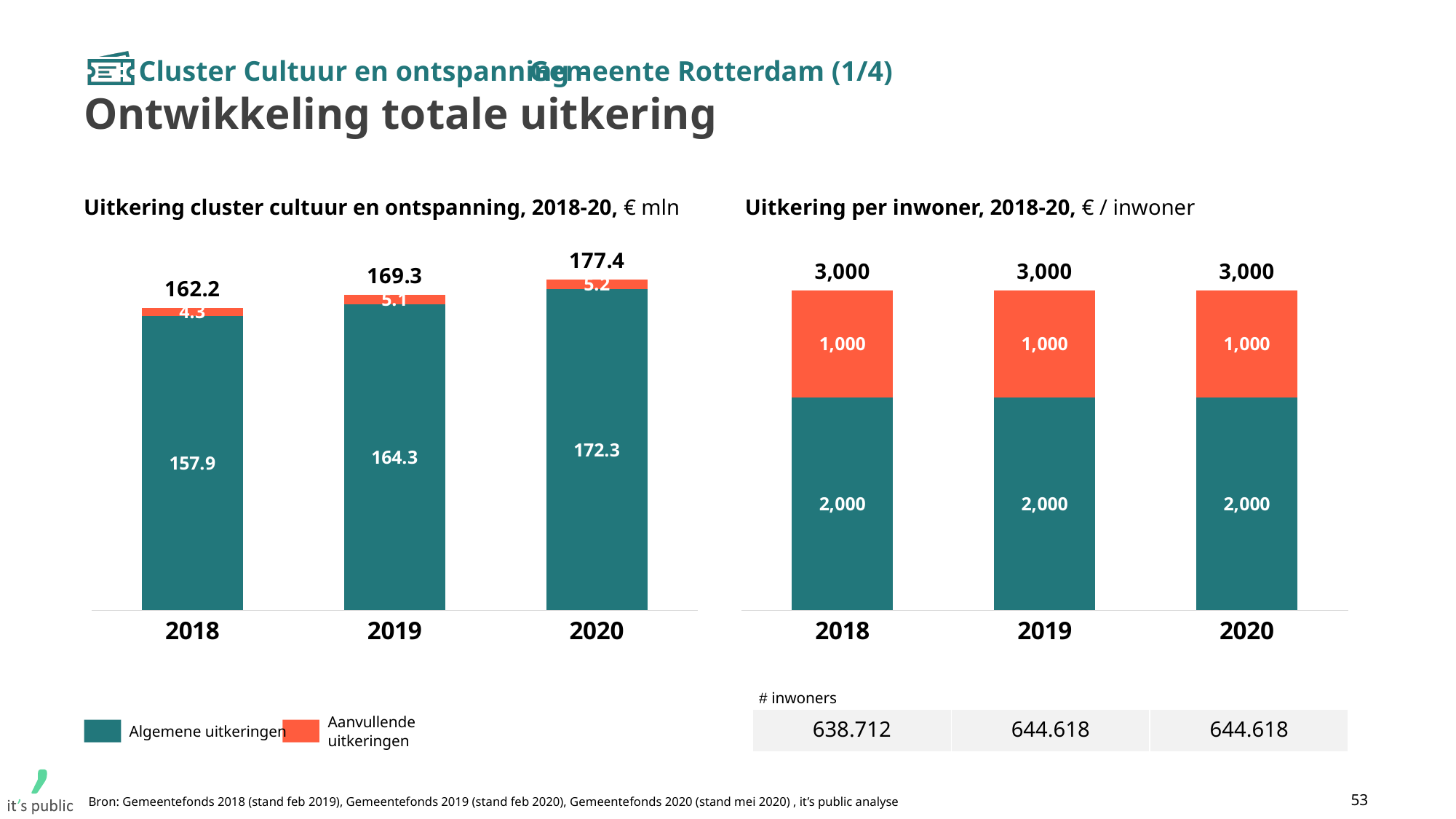
In the left chart (Uitkering cluster cultuur en ontspanning), what is the value of Algemene uitkeringen for 2020? 172.3 In the left chart (Uitkering cluster cultuur en ontspanning), what is the value of Aanvullende uitkeringen for 2018? 4.3 How many series does the legend list for the left chart? 2 In the left chart (Uitkering cluster cultuur en ontspanning), which year has the highest total uitkering? 2020 What kind of chart is the left chart (Uitkering cluster cultuur en ontspanning)? Stacked bar chart In the left chart (Uitkering cluster cultuur en ontspanning), what is the difference between the Algemene uitkeringen values for 2020 and 2018? 14.4 In the right chart (Uitkering per inwoner), what is the value of the orange (Aanvullende uitkeringen) segment for 2019? 1,000 In the left chart (Uitkering cluster cultuur en ontspanning), do the total values rise or fall from 2018 to 2020? rise In the right chart (Uitkering per inwoner), what is the total of the stacked bar for 2020? 3,000 In the left chart (Uitkering cluster cultuur en ontspanning), what is the total of the stacked bar for 2019? 169.3 In the left chart (Uitkering cluster cultuur en ontspanning), which year has the lowest Algemene uitkeringen value? 2018 In the left chart (Uitkering cluster cultuur en ontspanning), is the Aanvullende uitkeringen value larger in 2019 or in 2020? 2020